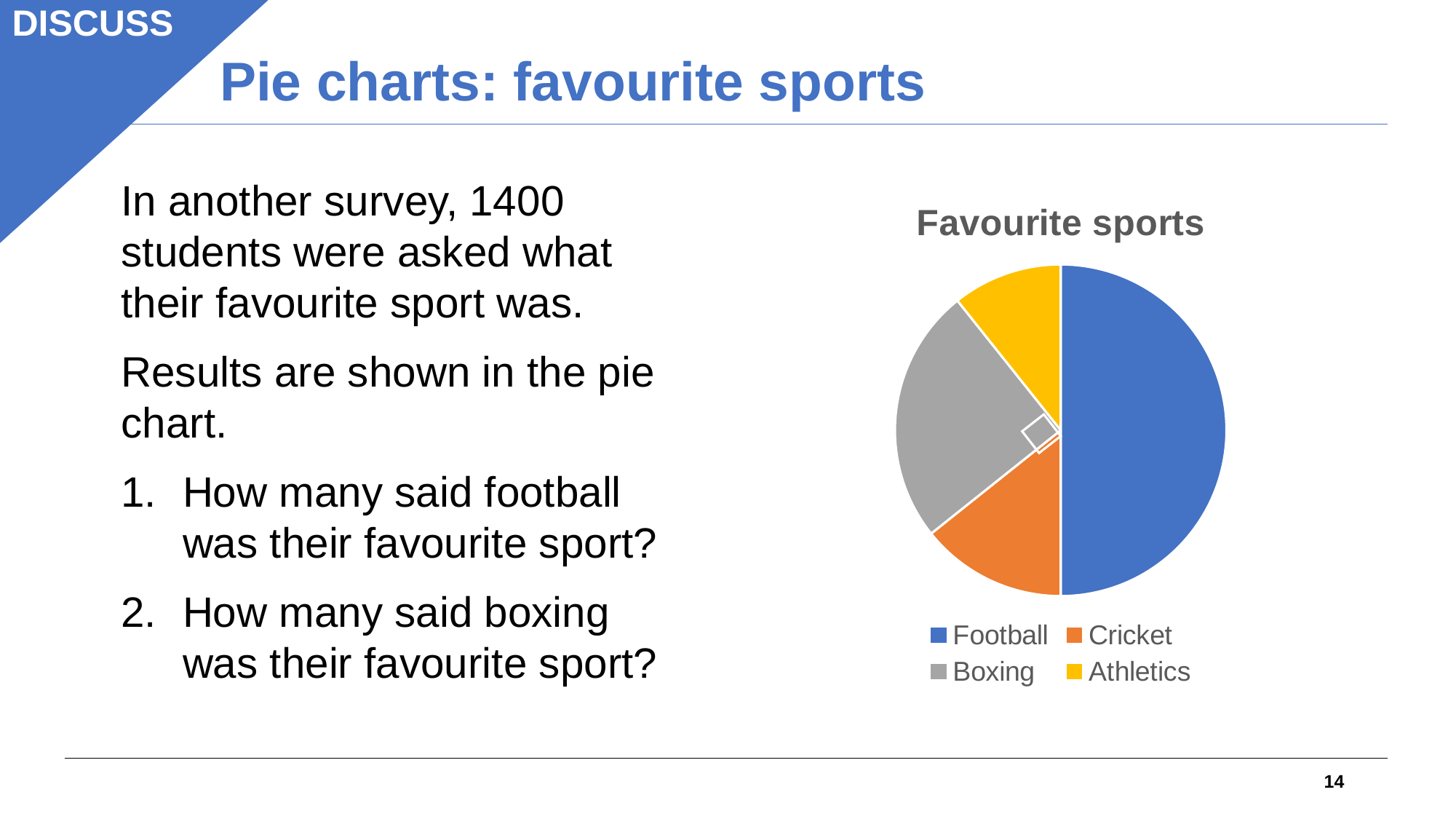
Which slice is larger, Football or Boxing? Football How many entries does the legend list? 4 How many categories does the pie chart show? 4 What share of the pie does the Boxing slice, marked with a right angle, represent? 25% What is the title of the chart? Favourite sports What kind of chart is shown on the slide? pie chart Which colour represents Football in the pie chart? blue Which slice is larger, Football or Cricket? Football Which slice is larger, Boxing or Athletics? Boxing Which sport has the largest slice of the pie chart? Football